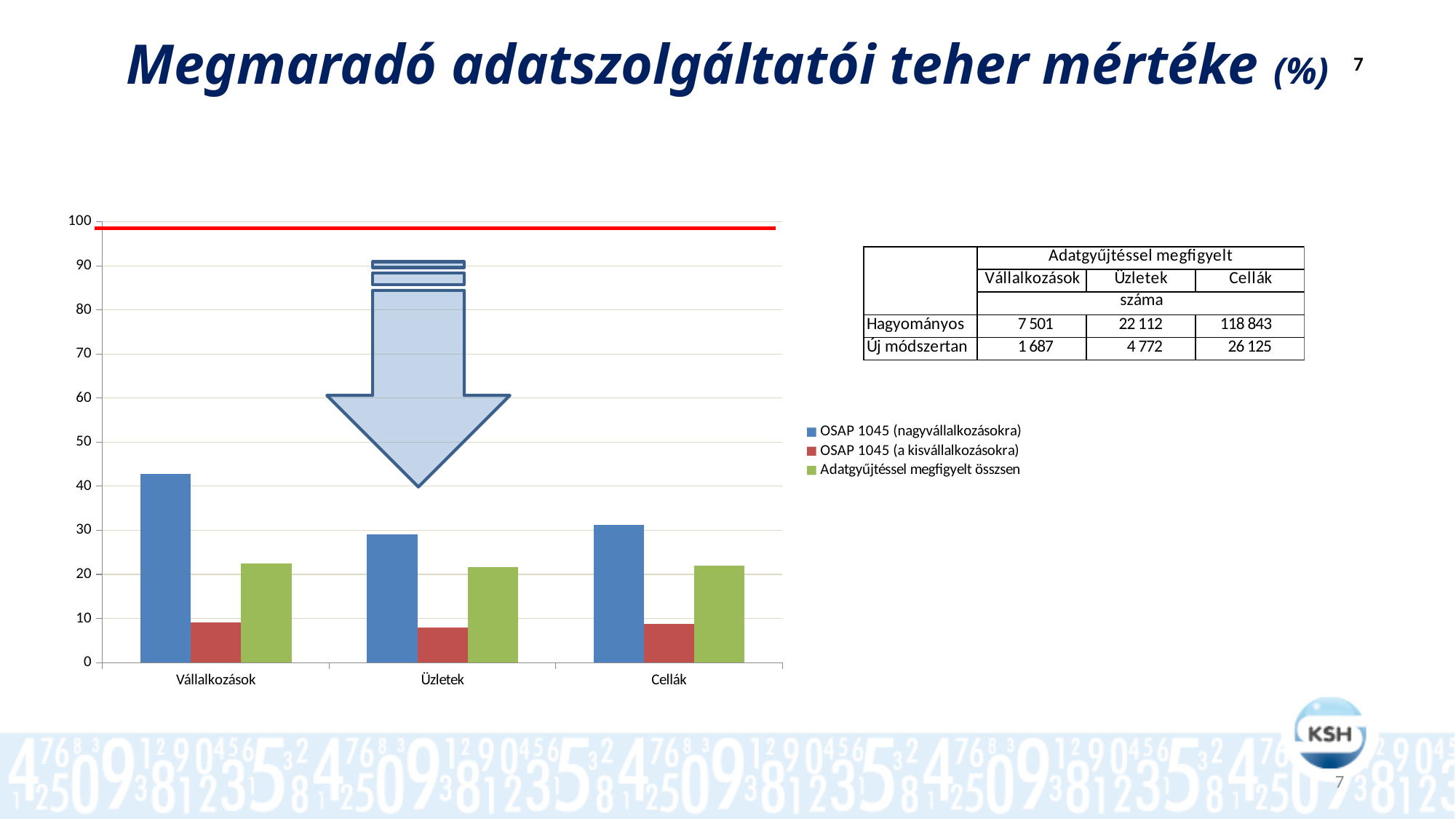
How many series does the chart legend list? 3 In the Vállalkozások category, which is larger: OSAP 1045 (nagyvállalkozásokra) or Adatgyűjtéssel megfigyelt összsen? OSAP 1045 (nagyvállalkozásokra) Is the value for OSAP 1045 (nagyvállalkozásokra) in the Üzletek category greater or less than 40? less In the Cellák category, which is larger: OSAP 1045 (a kisvállalkozásokra) or Adatgyűjtéssel megfigyelt összsen? Adatgyűjtéssel megfigyelt összsen Which is larger: the OSAP 1045 (nagyvállalkozásokra) value for Vállalkozások or for Üzletek? Vállalkozások Is the value for Adatgyűjtéssel megfigyelt összsen in the Üzletek category greater or less than 20? greater Which category has the highest value for the OSAP 1045 (nagyvállalkozásokra) series? Vállalkozások Is the value for OSAP 1045 (a kisvállalkozásokra) in the Cellák category greater or less than 10? less How many categories are shown on the x axis of the chart? 3 What kind of chart is shown on the slide? bar chart